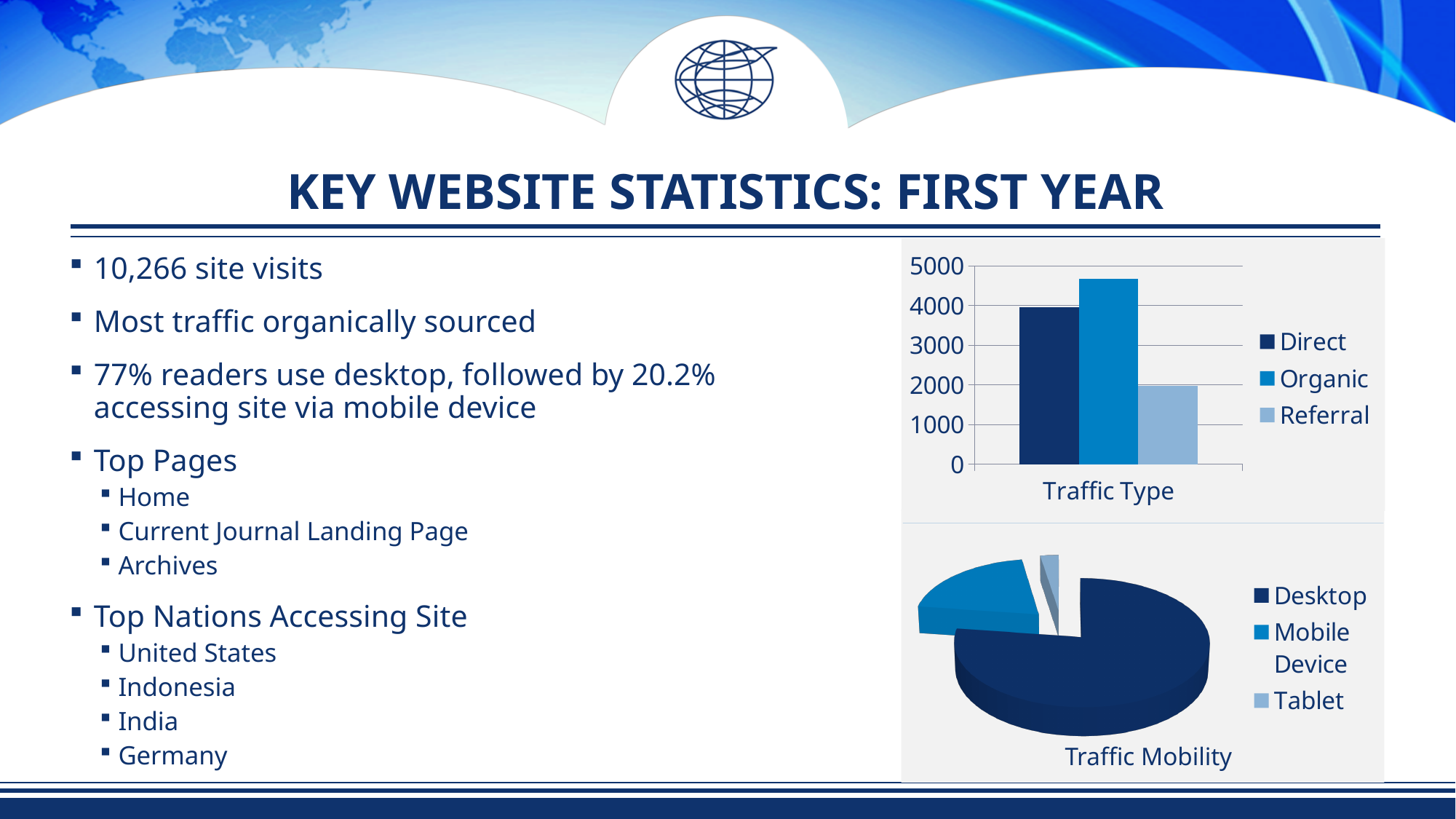
How many series does the legend of the Traffic Type chart list? 3 In the Traffic Type chart, which traffic type has the lowest value? Referral In the Traffic Type chart, is the value for Organic greater or less than 4000? greater In the Traffic Type chart, is the value for Referral greater or less than 3000? less In the Traffic Type chart, is the value for Direct greater or less than 3000? greater What kind of chart is the Traffic Type chart? bar chart How many slices does the Traffic Mobility pie chart have? 3 In the Traffic Mobility chart, which category has the smallest slice? Tablet In the Traffic Type chart, which is larger, Direct or Referral? Direct In the Traffic Type chart, which traffic type has the highest value? Organic What kind of chart is the Traffic Mobility chart? pie chart In the Traffic Mobility chart, which category has the largest slice? Desktop